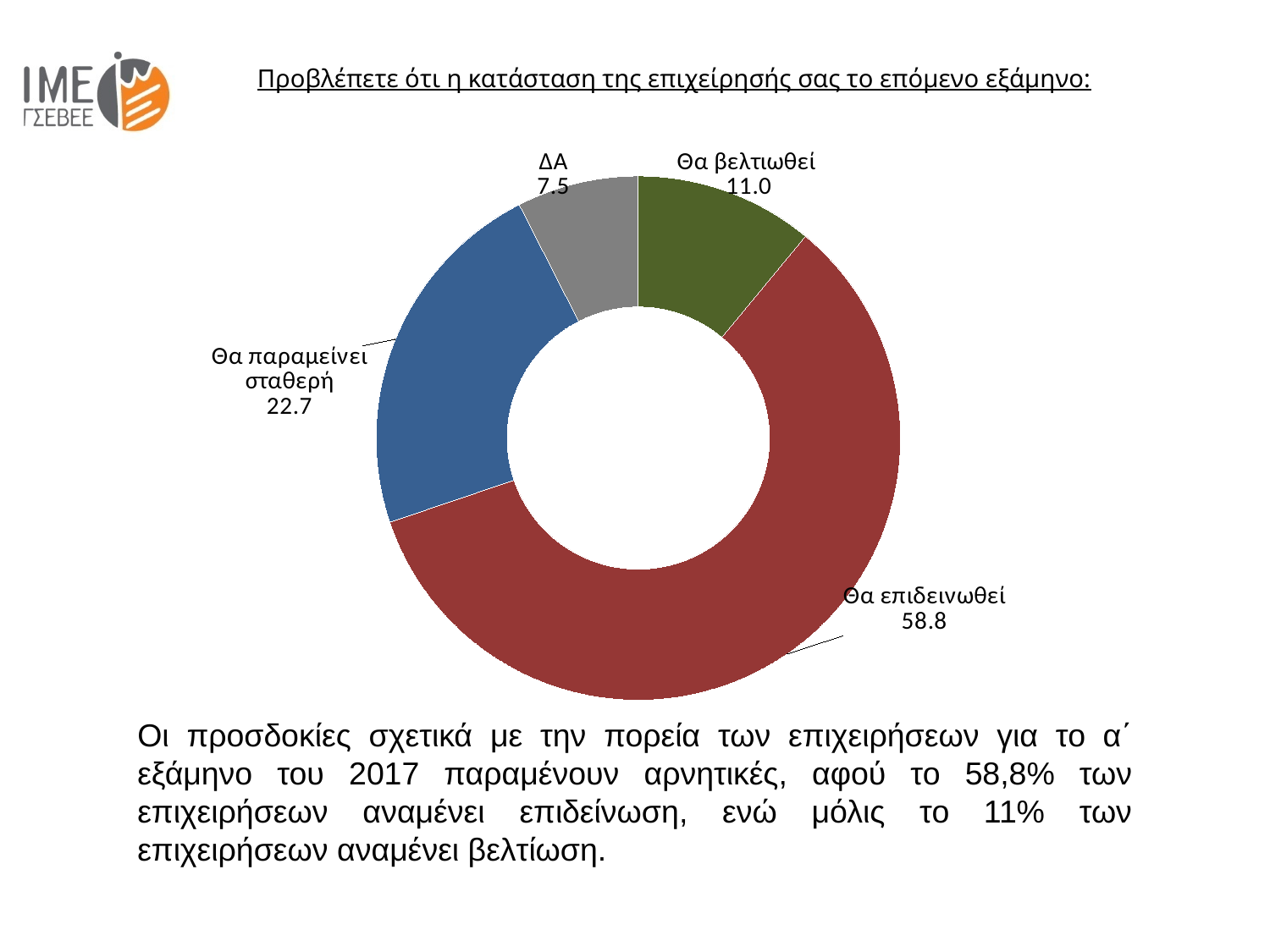
What value is shown for the "Θα παραμείνει σταθερή" slice? 22.7 How many categories are shown in the chart? 4 What is the difference between the values for "Θα βελτιωθεί" and "ΔΑ"? 3.5 Which is larger, the value for "Θα παραμείνει σταθερή" or the value for "Θα βελτιωθεί"? Θα παραμείνει σταθερή Which category has the smallest slice in the chart? ΔΑ What kind of chart is shown on the slide? Doughnut (pie) chart Which category has the largest slice in the chart? Θα επιδεινωθεί What value is shown for the "ΔΑ" slice? 7.5 What is the difference between the values for "Θα επιδεινωθεί" and "Θα παραμείνει σταθερή"? 36.1 What value is shown for the "Θα βελτιωθεί" slice? 11.0 What value is shown for the "Θα επιδεινωθεί" slice? 58.8 What colour is the "Θα επιδεινωθεί" slice? Red